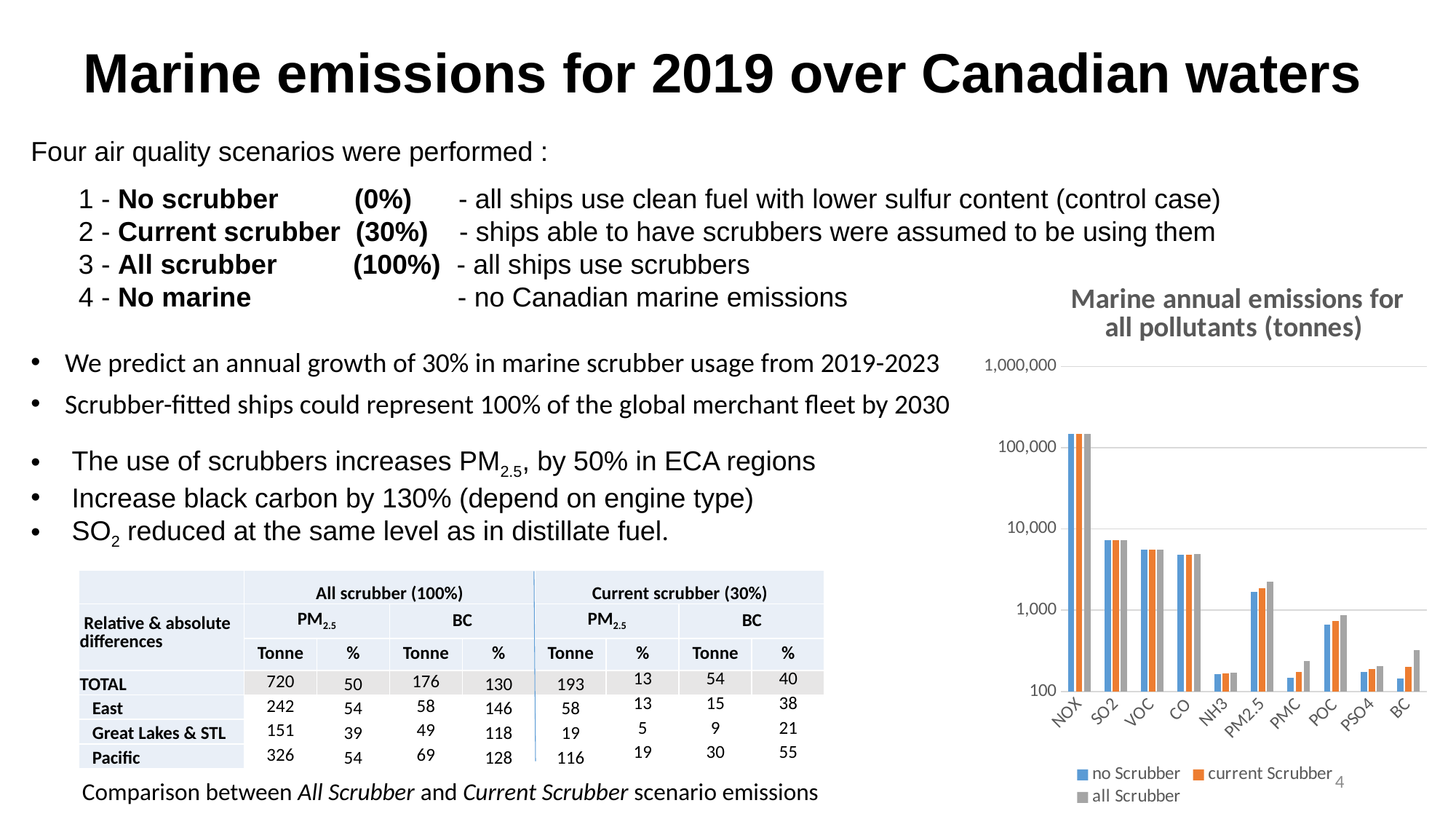
How many pollutant categories are shown on the x axis of the chart? 10 What type of chart is shown on the slide? bar chart What is the title of the chart? Marine annual emissions for all pollutants (tonnes) Which series is shown in orange in the chart legend? current Scrubber Is the no Scrubber value for NOX greater or less than 100,000? greater How many series does the chart legend list? 3 Which pollutant has the highest emissions in the chart? NOX Which has higher emissions in the chart, NOX or SO2? NOX Which has higher emissions in the chart, PM2.5 or NH3? PM2.5 Is the all Scrubber value for PM2.5 greater or less than 1,000? greater Is the no Scrubber value for SO2 greater or less than 10,000? less